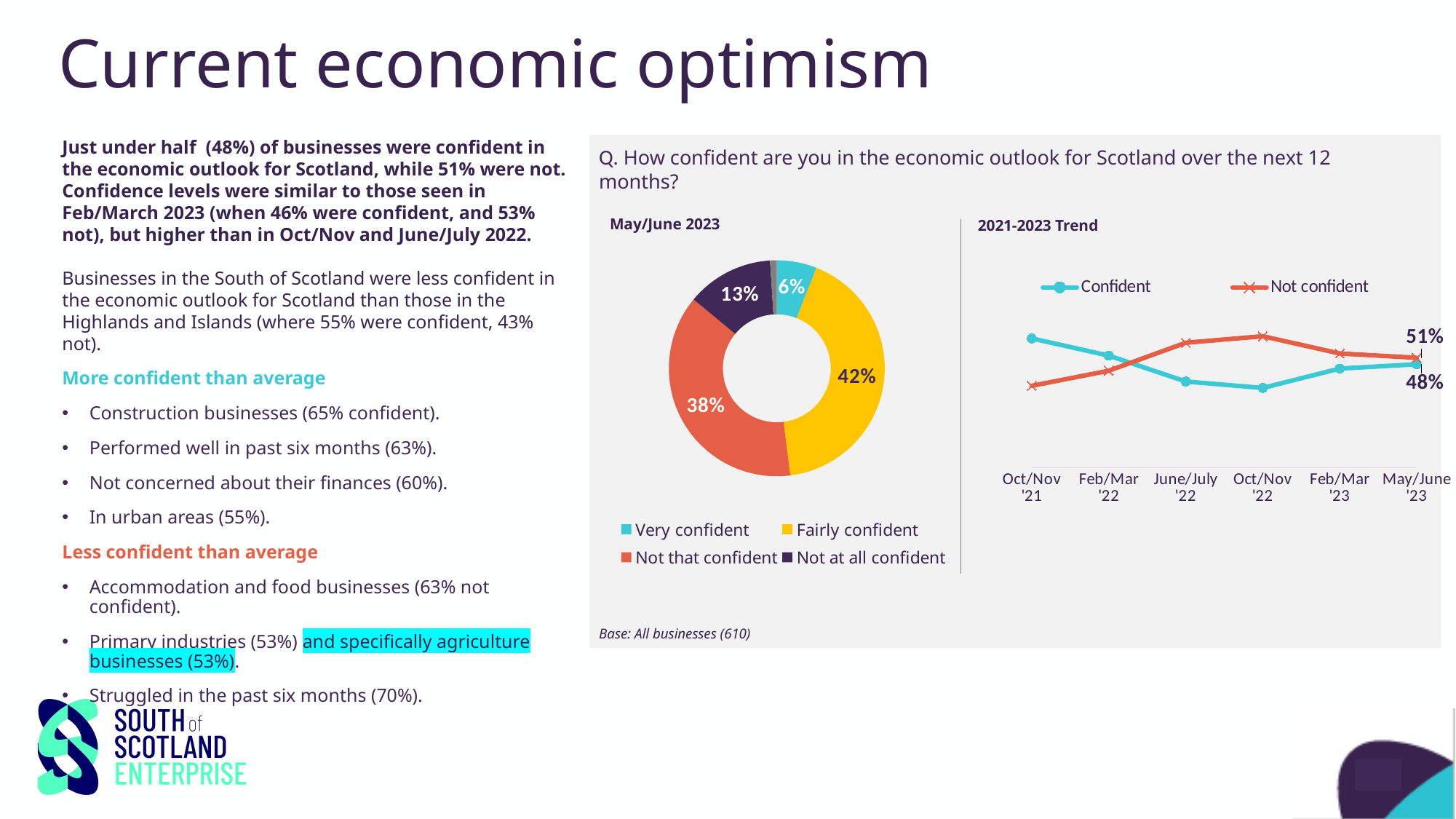
How many categories does the legend of the May/June 2023 donut chart list? 4 In the 2021-2023 Trend chart, what is the Not confident value for May/June '23? 51% In the May/June 2023 donut chart, what percentage of businesses were not that confident? 38% In the 2021-2023 Trend chart, what is the Confident value for May/June '23? 48% In the 2021-2023 Trend chart, which series is higher at Oct/Nov '21, Confident or Not confident? Confident In the May/June 2023 donut chart, what percentage of businesses were fairly confident? 42% In the May/June 2023 donut chart, which category has the largest share? Fairly confident How many series does the legend of the 2021-2023 Trend chart list? 2 What kind of chart is the May/June 2023 chart? Donut (pie) chart How many time points are shown on the x axis of the 2021-2023 Trend chart? 6 In the May/June 2023 donut chart, what percentage of businesses were not at all confident? 13% In the May/June 2023 donut chart, what is the difference in percentage points between the fairly confident and not that confident shares? 4 percentage points